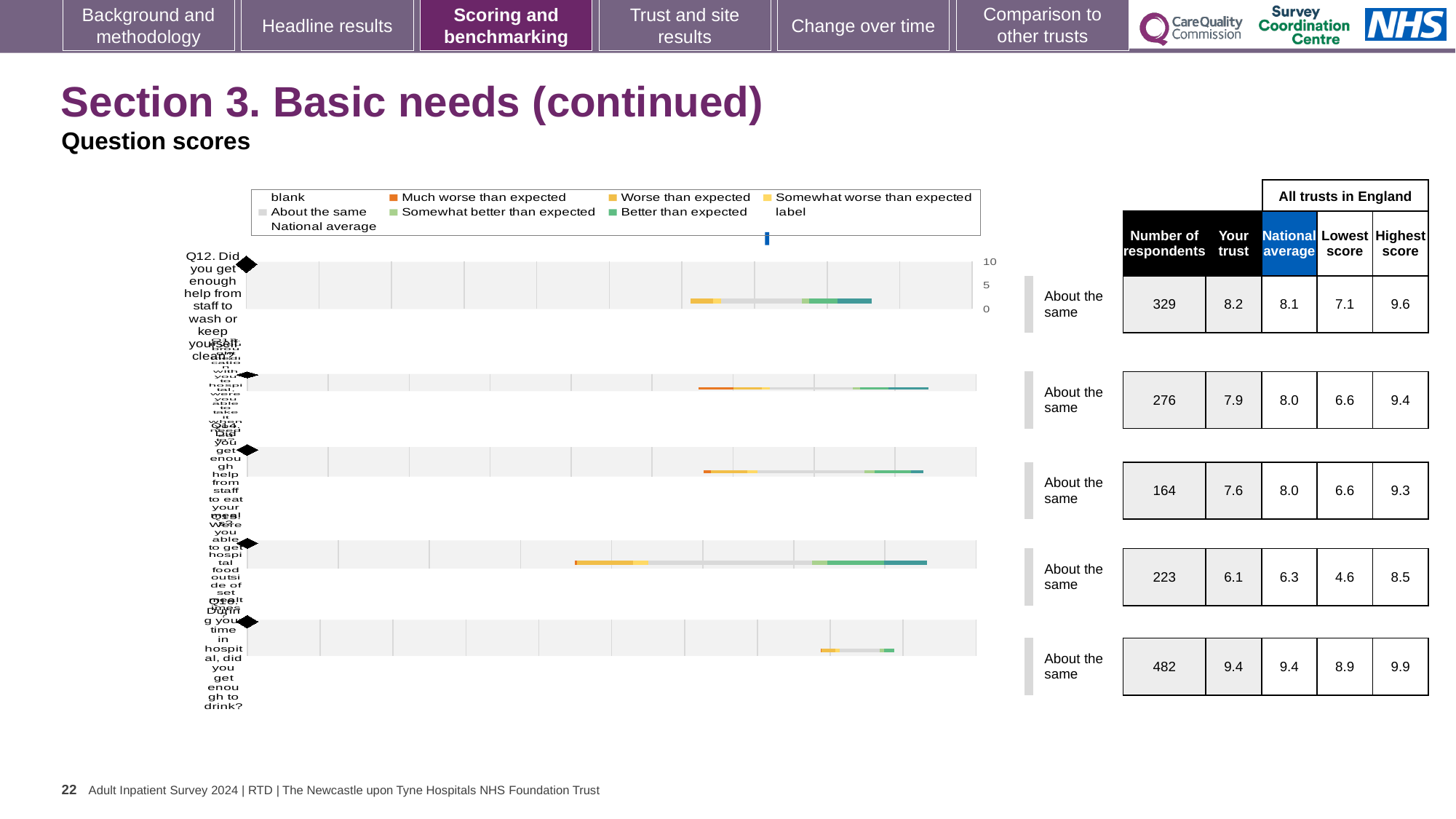
For Q12 (the first row), which is larger: the 'Your trust' score or the national average? Your trust What is the national average score for Q12 (the first row)? 8.1 What colour does the legend use for 'Much worse than expected'? orange What is the number of respondents for Q12 (the first row), as shown in the table beside the chart? 329 What is the 'Your trust' score for Q12 (the first row)? 8.2 Which row has the highest 'Your trust' score? the fifth row (Q16), 9.4 What kind of chart is used to show the question scores on this slide? bar chart Which row has the lowest 'Your trust' score? the fourth row (Q15), 6.1 What is the number of respondents for the fifth row (Q16)? 482 For Q12 (the first row), what is the difference between the highest score and the lowest score across all trusts in England? 2.5 How many question rows are plotted in the chart? 5 What benchmark category is shown for every question row on this slide? About the same